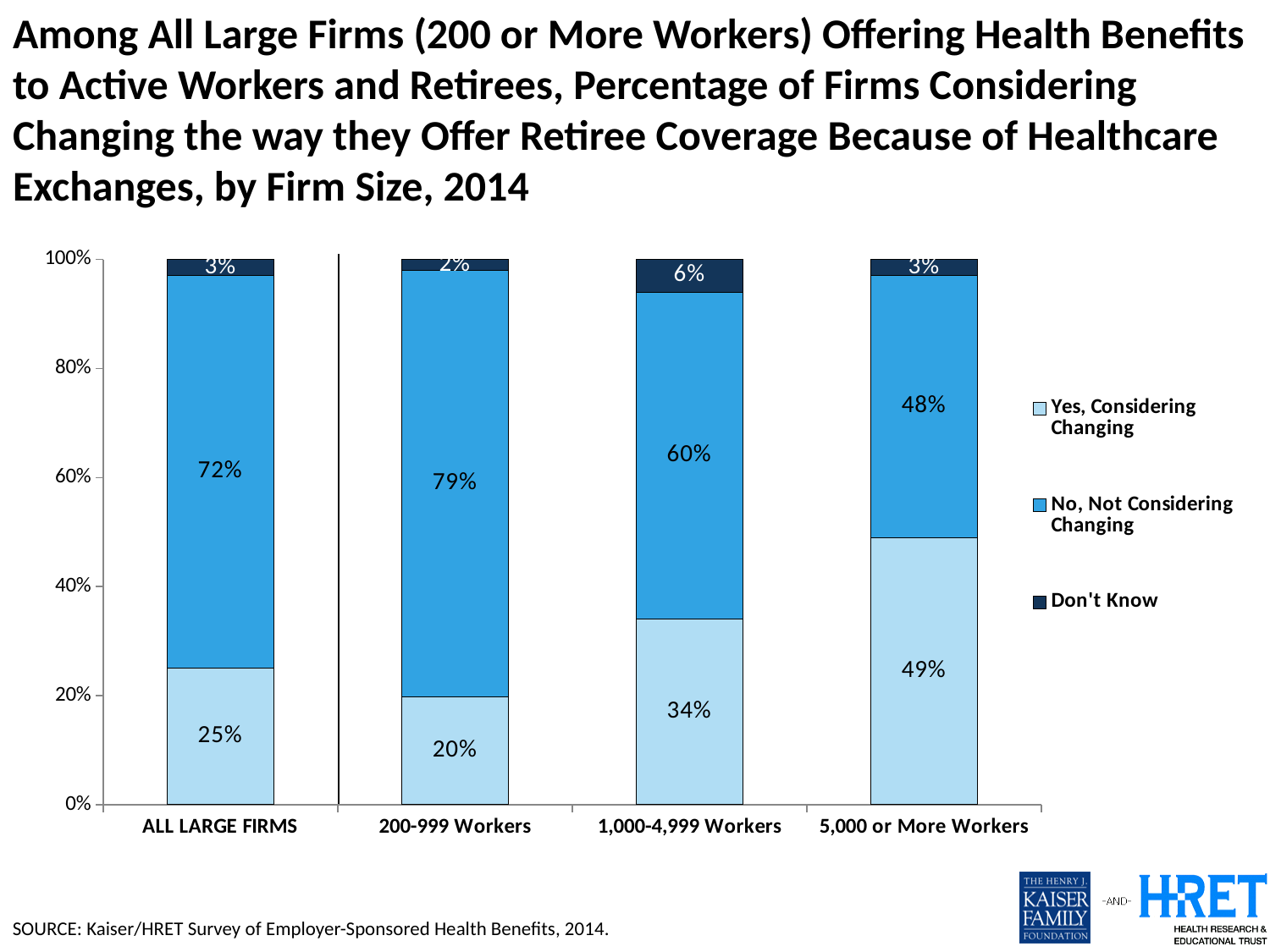
How many series does the legend list? 3 What is the 'No, Not Considering Changing' value for firms with 1,000-4,999 workers? 60% How many firm size categories are shown on the x axis? 4 Which firm size category has the lowest 'No, Not Considering Changing' percentage? 5,000 or More Workers What is the 'Don't Know' value for firms with 5,000 or more workers? 3% Which is larger: the 'Don't Know' value for 1,000-4,999 Workers or for ALL LARGE FIRMS? 1,000-4,999 Workers What is the difference between the 'Yes, Considering Changing' values for 5,000 or More Workers and 200-999 Workers? 29 percentage points Which firm size category has the highest 'Yes, Considering Changing' percentage? 5,000 or More Workers Which legend entry is shown in the darkest blue colour? Don't Know What kind of chart is shown on the slide? Stacked bar chart What is the 'Yes, Considering Changing' value for ALL LARGE FIRMS? 25% What percentage of firms with 200-999 workers are considering changing the way they offer retiree coverage? 20%